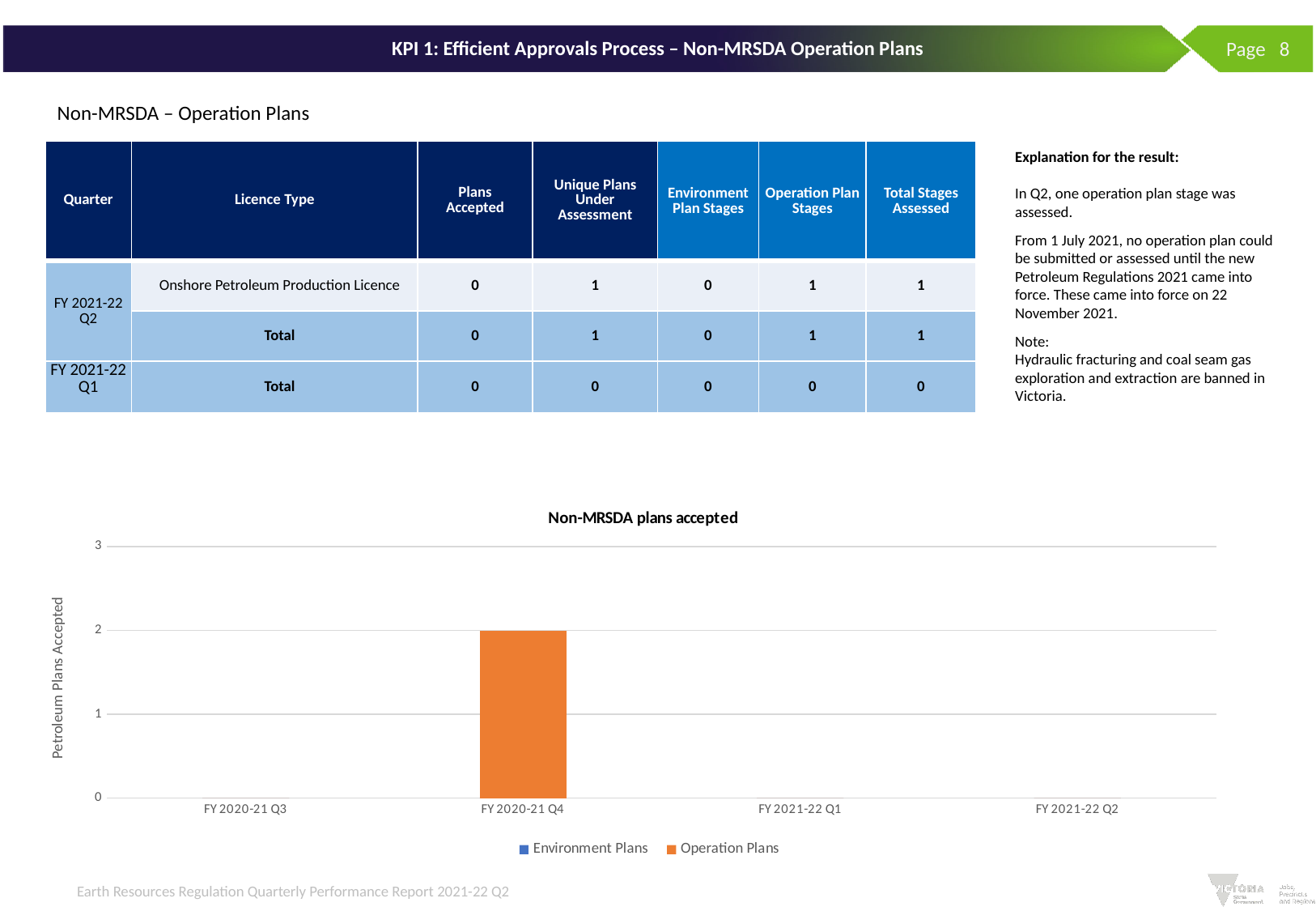
What is the label on the vertical axis of the chart? Petroleum Plans Accepted What is the highest value shown on the vertical axis of the chart? 3 How many quarters are shown on the x axis of the chart? 4 Is the value for Operation Plans in FY 2020-21 Q4 greater or less than 3? less Which quarter has the highest value for Operation Plans in the chart? FY 2020-21 Q4 Which is larger in the chart: Operation Plans for FY 2020-21 Q4 or Operation Plans for FY 2021-22 Q1? FY 2020-21 Q4 How many series does the chart legend list? 2 What is the title of the chart on the slide? Non-MRSDA plans accepted What kind of chart is shown on the slide? bar chart Is the value for Operation Plans in FY 2020-21 Q4 greater or less than 1? greater What is the value of Operation Plans for FY 2020-21 Q4 in the chart? 2